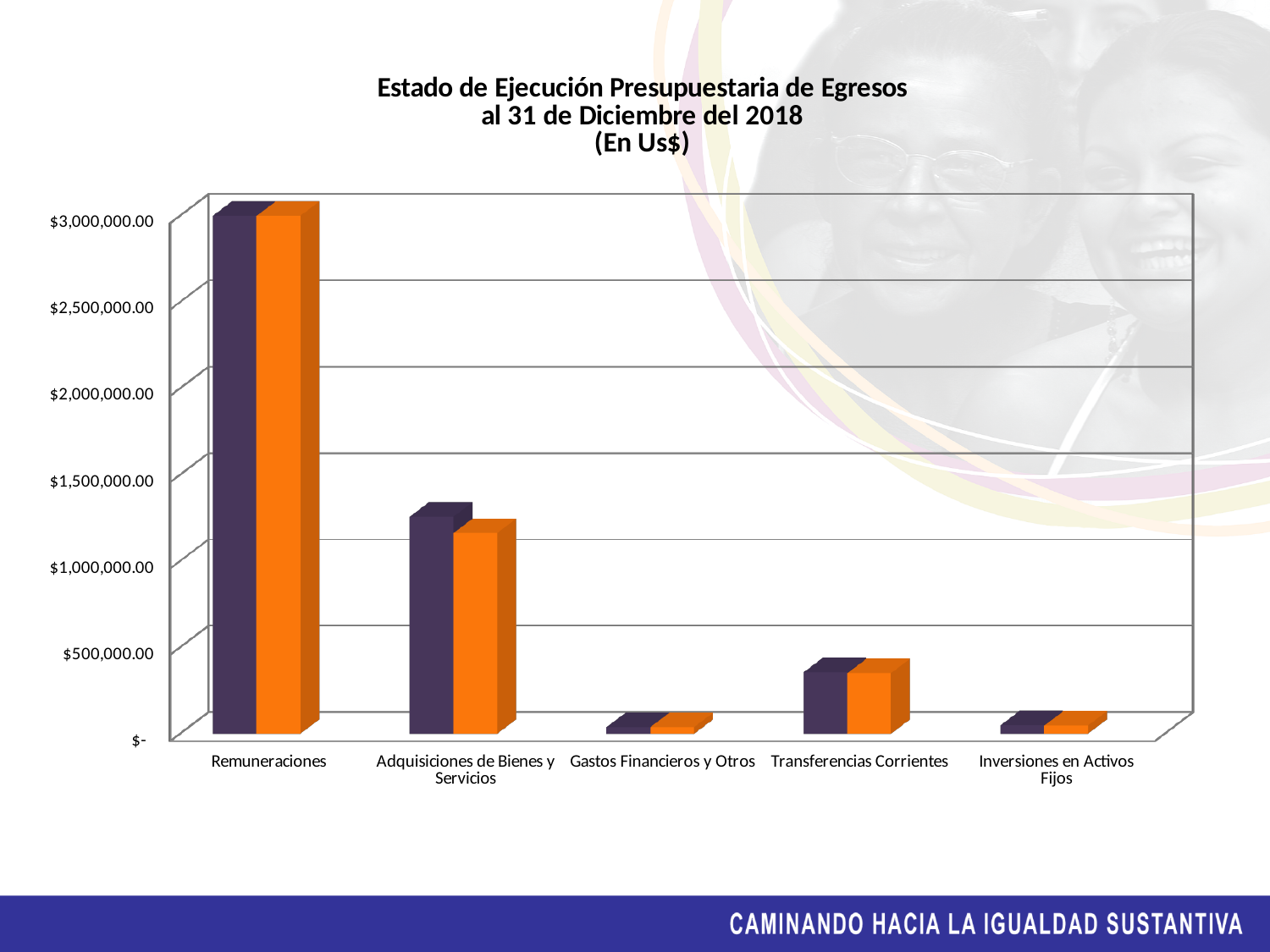
Is the value for Adquisiciones de Bienes y Servicios greater or less than $1,500,000.00? less Which is larger, the value for Transferencias Corrientes or the value for Adquisiciones de Bienes y Servicios? Adquisiciones de Bienes y Servicios Which is larger, the value for Remuneraciones or the value for Adquisiciones de Bienes y Servicios? Remuneraciones Is the value for Transferencias Corrientes greater or less than $500,000.00? less How many categories are shown on the x axis of the chart? 5 Which is larger, the value for Transferencias Corrientes or the value for Gastos Financieros y Otros? Transferencias Corrientes Is the value for Remuneraciones greater or less than $2,500,000.00? greater What is the title of the chart? Estado de Ejecución Presupuestaria de Egresos al 31 de Diciembre del 2018 (En Us$) What two colours are used for the bars in the chart? Purple and orange What kind of chart is shown on the slide? Bar chart Which category has the highest values in the chart? Remuneraciones